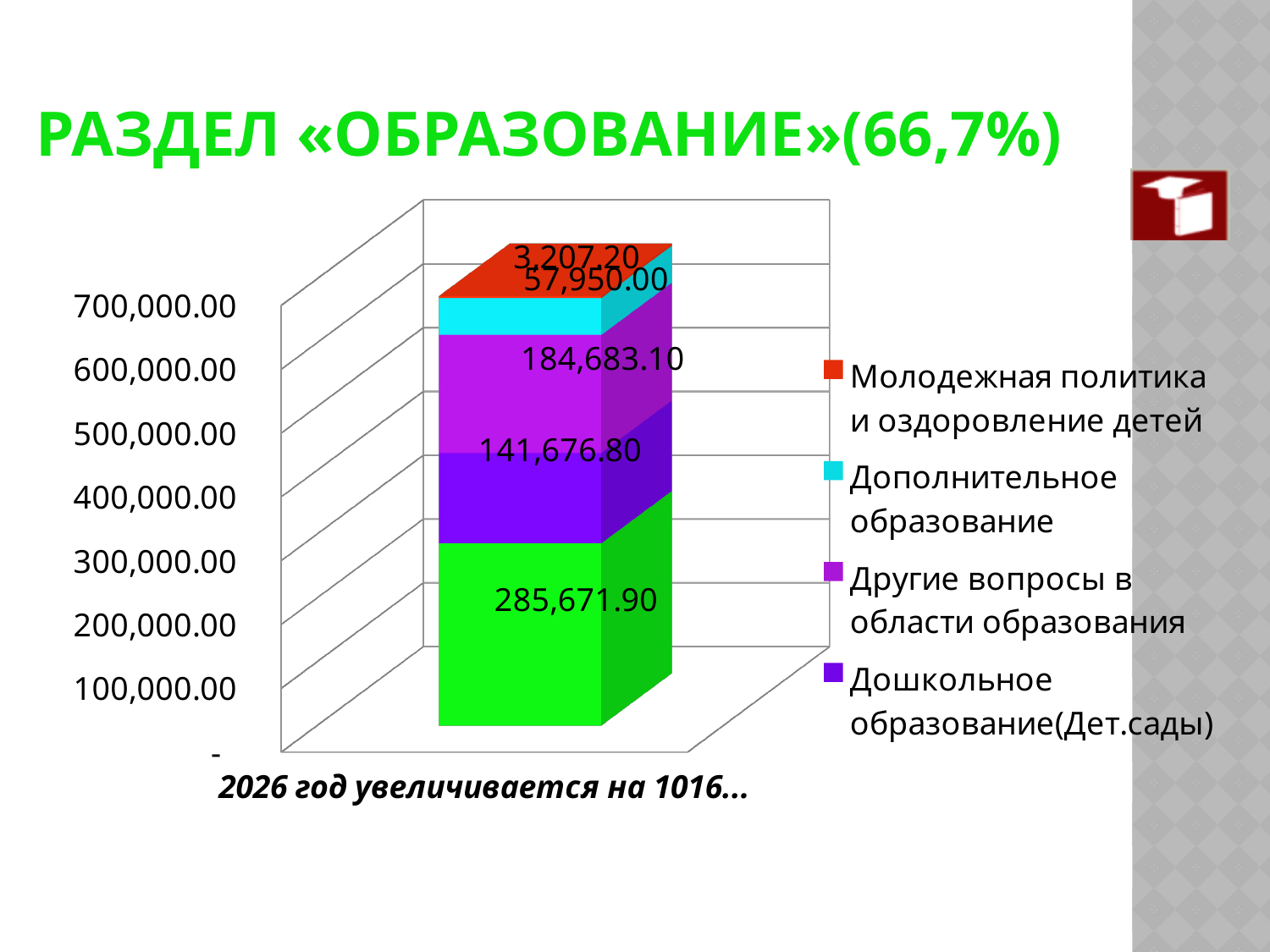
What is the total of all segments in the stacked bar? 673,189.00 What is the value of the Молодежная политика и оздоровление детей segment? 3,207.20 What is the difference between the Другие вопросы в области образования and Дошкольное образование(Дет.сады) values? 43,006.30 What is the value of the Дополнительное образование segment? 57,950.00 Which is larger: Дополнительное образование or Молодежная политика и оздоровление детей? Дополнительное образование What is the largest data label shown on the bar? 285,671.90 What is the value of the Другие вопросы в области образования segment? 184,683.10 What kind of chart is shown on the slide? Stacked bar chart Is the total height of the stacked bar greater or less than 600,000.00? greater What is the value of the Дошкольное образование(Дет.сады) segment? 141,676.80 Which legend series has the smallest value in the bar? Молодежная политика и оздоровление детей How many series does the legend list? 4